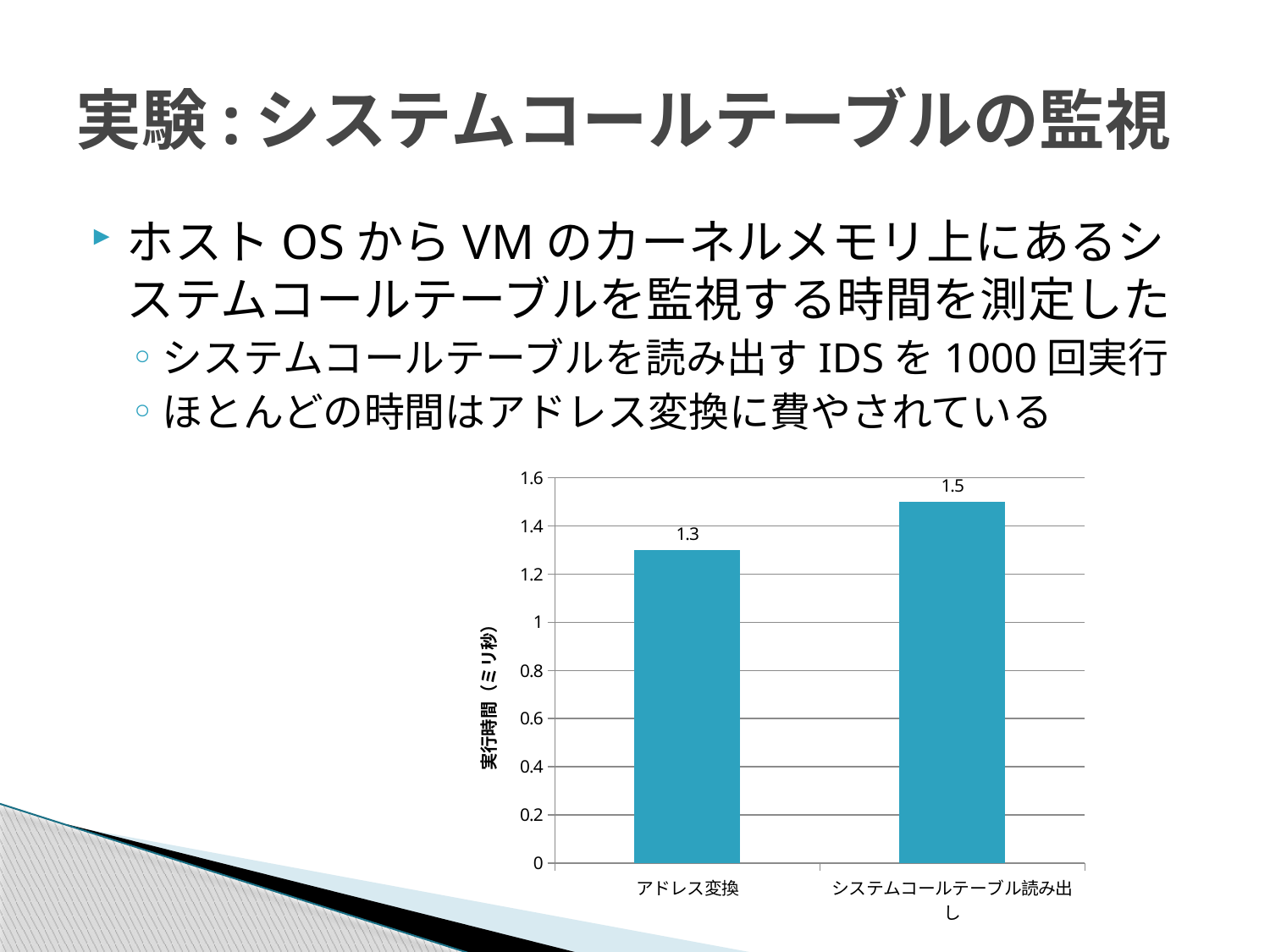
What is the difference between the values for システムコールテーブル読み出し and アドレス変換? 0.2 What is the label of the vertical axis? 実行時間（ミリ秒） What is the value for システムコールテーブル読み出し? 1.5 Is the value for アドレス変換 greater or less than 1.2? greater What is the value for アドレス変換? 1.3 Is the value for システムコールテーブル読み出し greater or less than 1.6? less How many categories are shown on the x axis? 2 Which category has the lowest value? アドレス変換 What is the highest tick value shown on the vertical axis? 1.6 Which is larger, the value for アドレス変換 or the value for システムコールテーブル読み出し? システムコールテーブル読み出し What kind of chart is shown on the slide? bar chart Which category has the highest value? システムコールテーブル読み出し